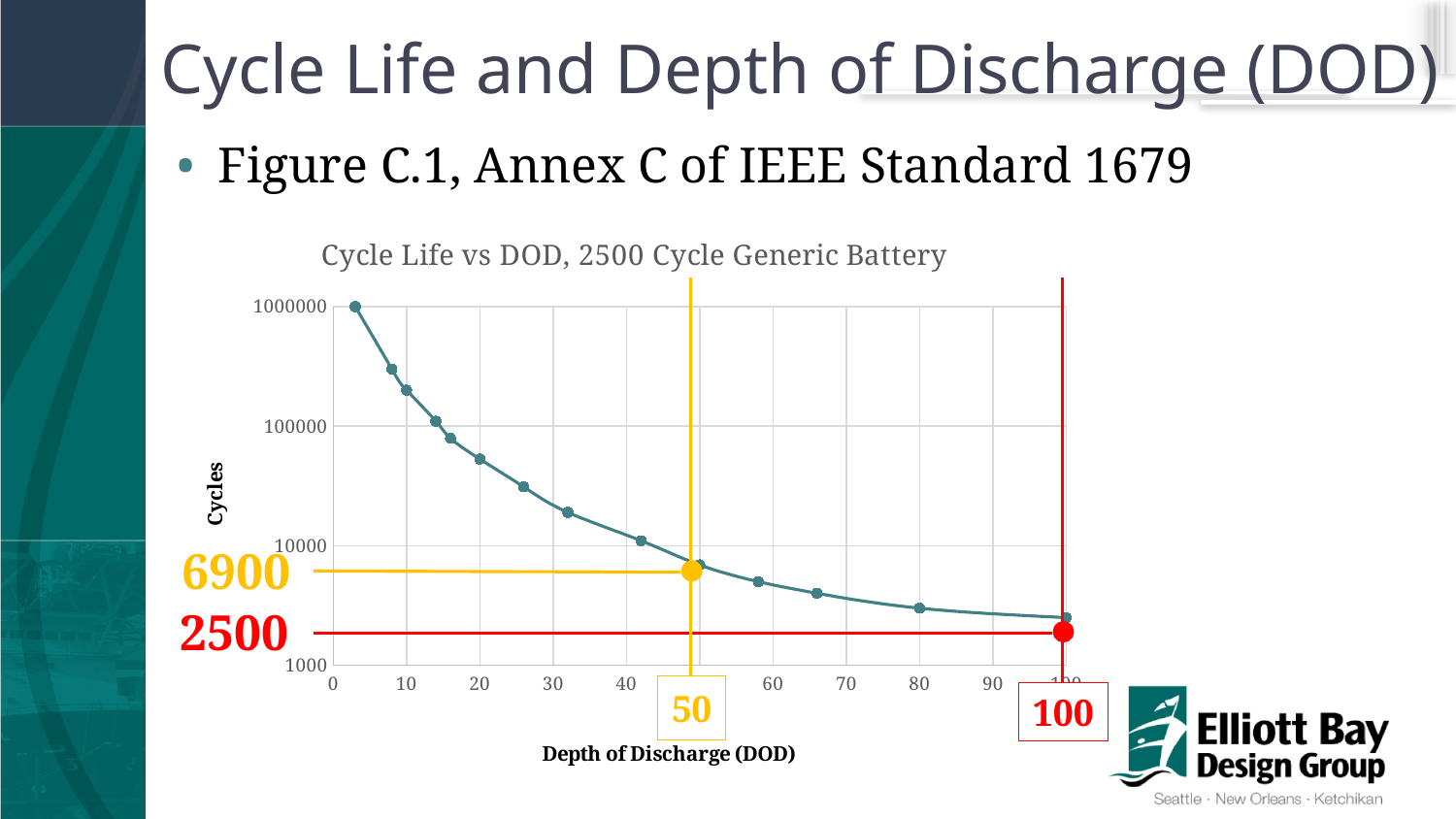
What is the highest number of cycles plotted on the chart? 1000000 Which depth of discharge gives more cycles, 50 or 100? 50 Do the cycle values rise or fall as depth of discharge increases? fall How many cycles does the chart mark at a depth of discharge of 100? 2500 Is the number of cycles at a depth of discharge of 80 greater or less than 10000? less Is the number of cycles at a depth of discharge of 20 greater or less than 10000? greater Is the number of cycles at a depth of discharge of 30 greater or less than 100000? less What is the title of the chart? Cycle Life vs DOD, 2500 Cycle Generic Battery What is the difference in cycles between the marked values at 50 DOD and 100 DOD? 4400 What is the label of the x axis? Depth of Discharge (DOD) What kind of chart is shown on the slide? line chart How many cycles does the chart mark at a depth of discharge of 50? 6900